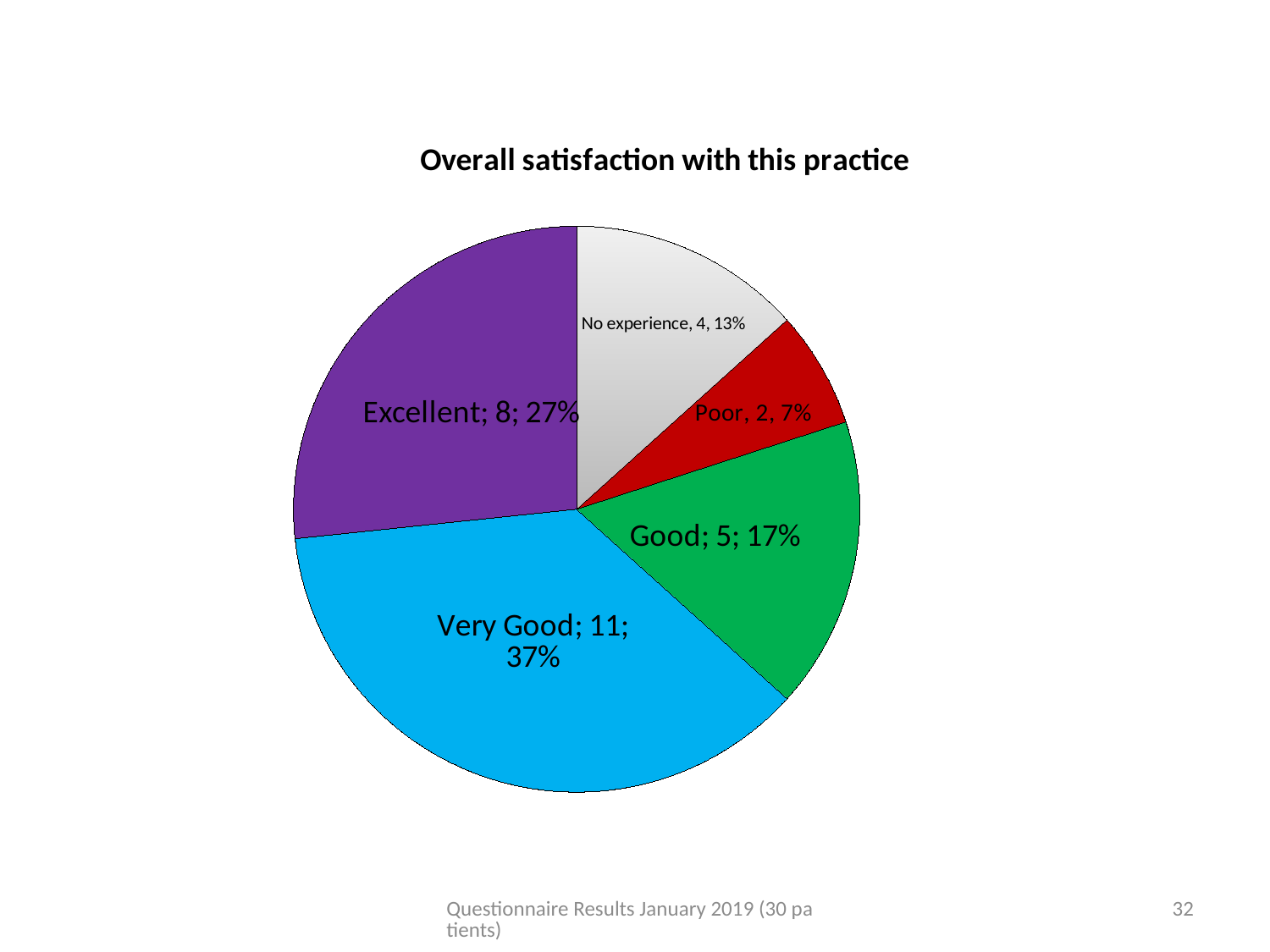
What percentage share does the Excellent slice have? 27% Which category has the largest slice? Very Good What kind of chart is shown on the slide? pie chart What colour is the Very Good slice? blue Which has more responses, Excellent or Good? Excellent How many responses are in the No experience slice? 4 What is the title of the chart? Overall satisfaction with this practice How many slices does the pie chart have? 5 Which category has the smallest slice? Poor What percentage share does the Poor slice have? 7% What is the difference in number of responses between Very Good and Good? 6 How many responses are in the Very Good slice? 11